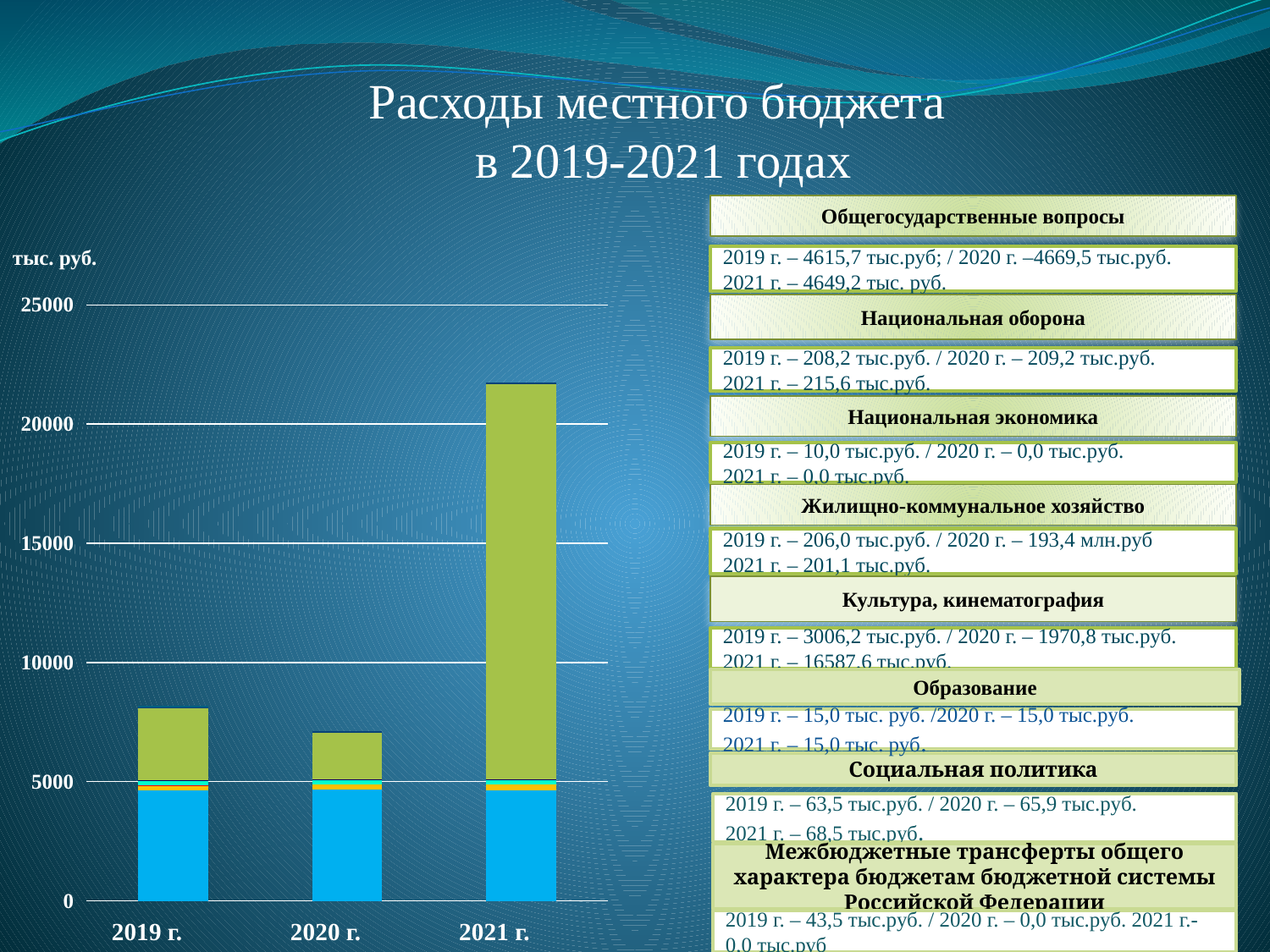
Is the total bar height for 2019 г. greater or less than 10000? less Is the total bar height for 2021 г. greater or less than 25000? less What kind of chart is shown on the slide? bar chart Is the total bar height for 2020 г. greater or less than 10000? less Which bar is taller, 2021 г. or 2019 г.? 2021 г. Which bar is taller, 2019 г. or 2020 г.? 2019 г. What unit is shown above the y axis of the chart? тыс. руб. Which year has the tallest bar in the chart? 2021 г. Does the total bar height rise or fall from 2020 г. to 2021 г.? rise Which year has the shortest bar in the chart? 2020 г. How many years (categories) are shown on the x axis of the chart? 3